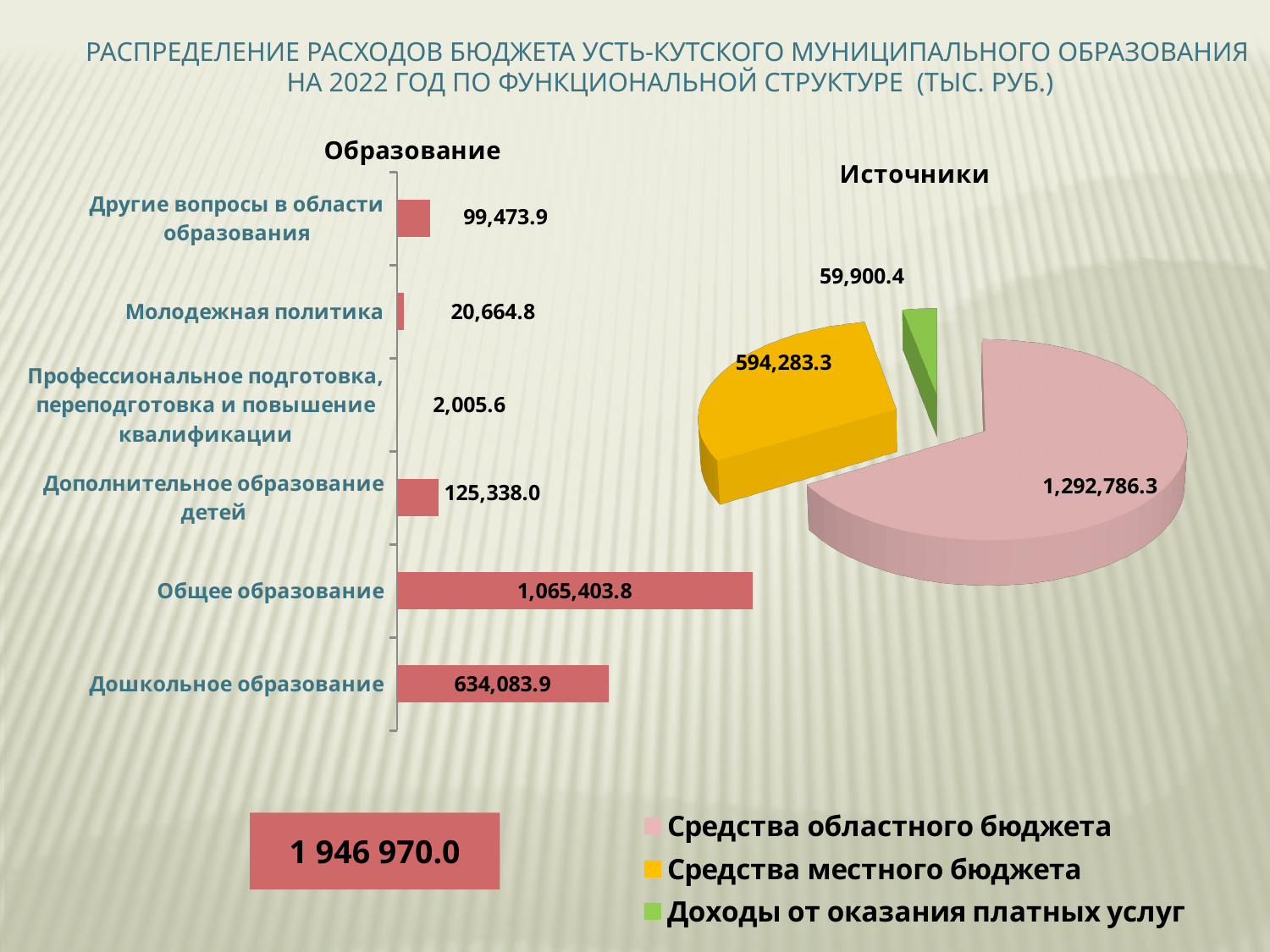
In the 'Образование' bar chart, what is the value for Молодежная политика? 20,664.8 In the 'Источники' pie chart, which source has the largest slice? Средства областного бюджета In the 'Образование' bar chart, which category has the lowest value? Профессиональное подготовка, переподготовка и повышение квалификации In the 'Образование' bar chart, what is the difference between Общее образование and Дошкольное образование? 431,319.9 In the 'Образование' bar chart, which category has the highest value? Общее образование What type of chart is the 'Образование' chart? Bar chart How many entries does the legend of the 'Источники' pie chart list? 3 In the 'Образование' bar chart, what is the value for Общее образование? 1,065,403.8 In the 'Источники' pie chart, what is the value for Средства местного бюджета? 594,283.3 In the 'Образование' bar chart, which is larger: Дополнительное образование детей or Другие вопросы в области образования? Дополнительное образование детей How many categories does the 'Образование' bar chart show? 6 In the 'Источники' pie chart, what is the difference between Средства областного бюджета and Средства местного бюджета? 698,503.0